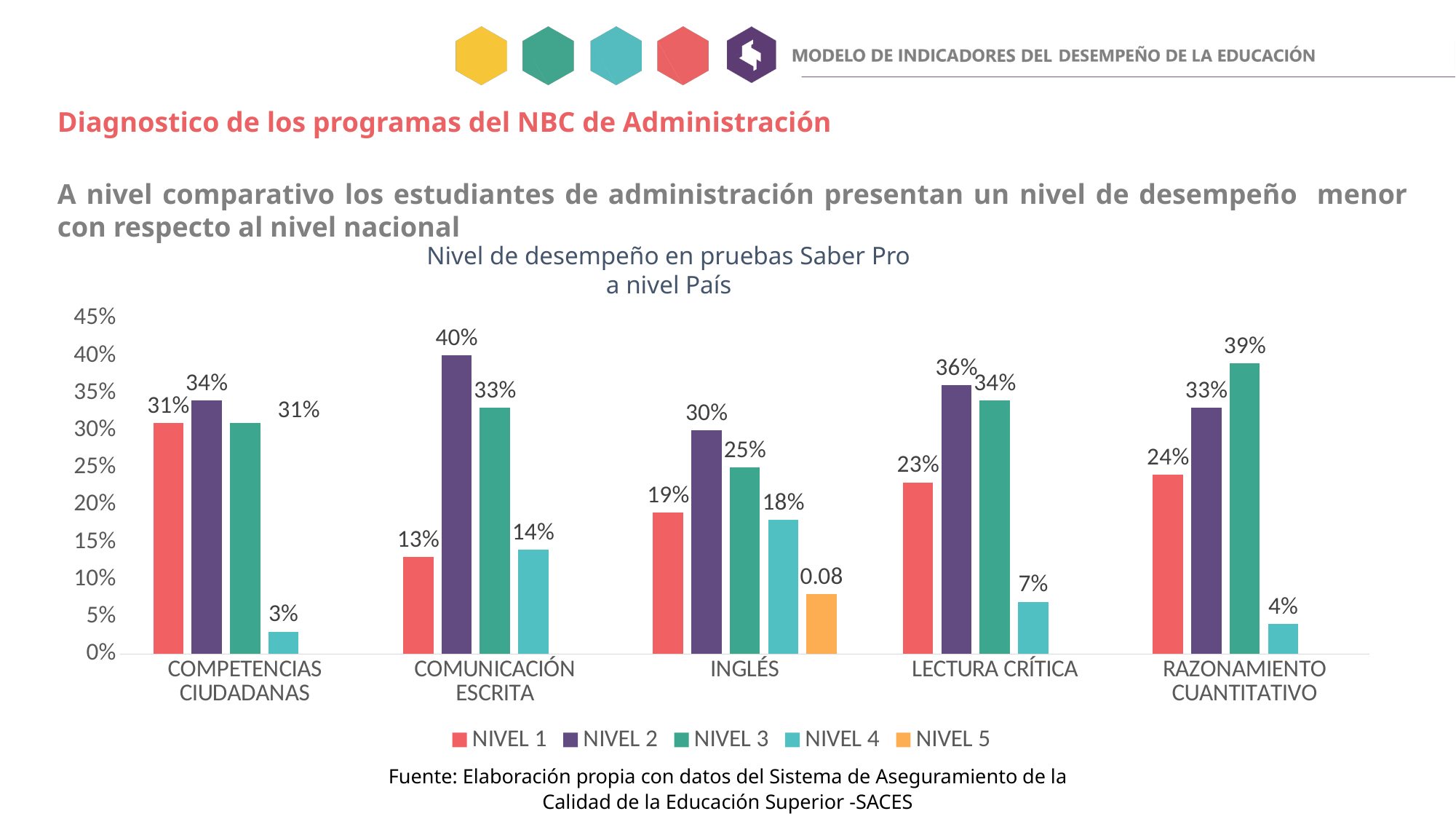
How many categories are shown on the x axis? 5 What is the value for NIVEL 4 in INGLÉS? 18% What is the value for NIVEL 2 in COMUNICACIÓN ESCRITA? 40% How many series does the legend list? 5 Which category has the lowest NIVEL 4 value? COMPETENCIAS CIUDADANAS What is the value for NIVEL 1 in RAZONAMIENTO CUANTITATIVO? 24% Which is larger in COMPETENCIAS CIUDADANAS: NIVEL 2 or NIVEL 3? NIVEL 2 What kind of chart is shown? Bar chart Which category has the highest NIVEL 3 value? RAZONAMIENTO CUANTITATIVO What is the value for NIVEL 5 in INGLÉS? 0.08 What is the difference between NIVEL 2 and NIVEL 1 in LECTURA CRÍTICA? 13% What is the title of the chart? Nivel de desempeño en pruebas Saber Pro a nivel País